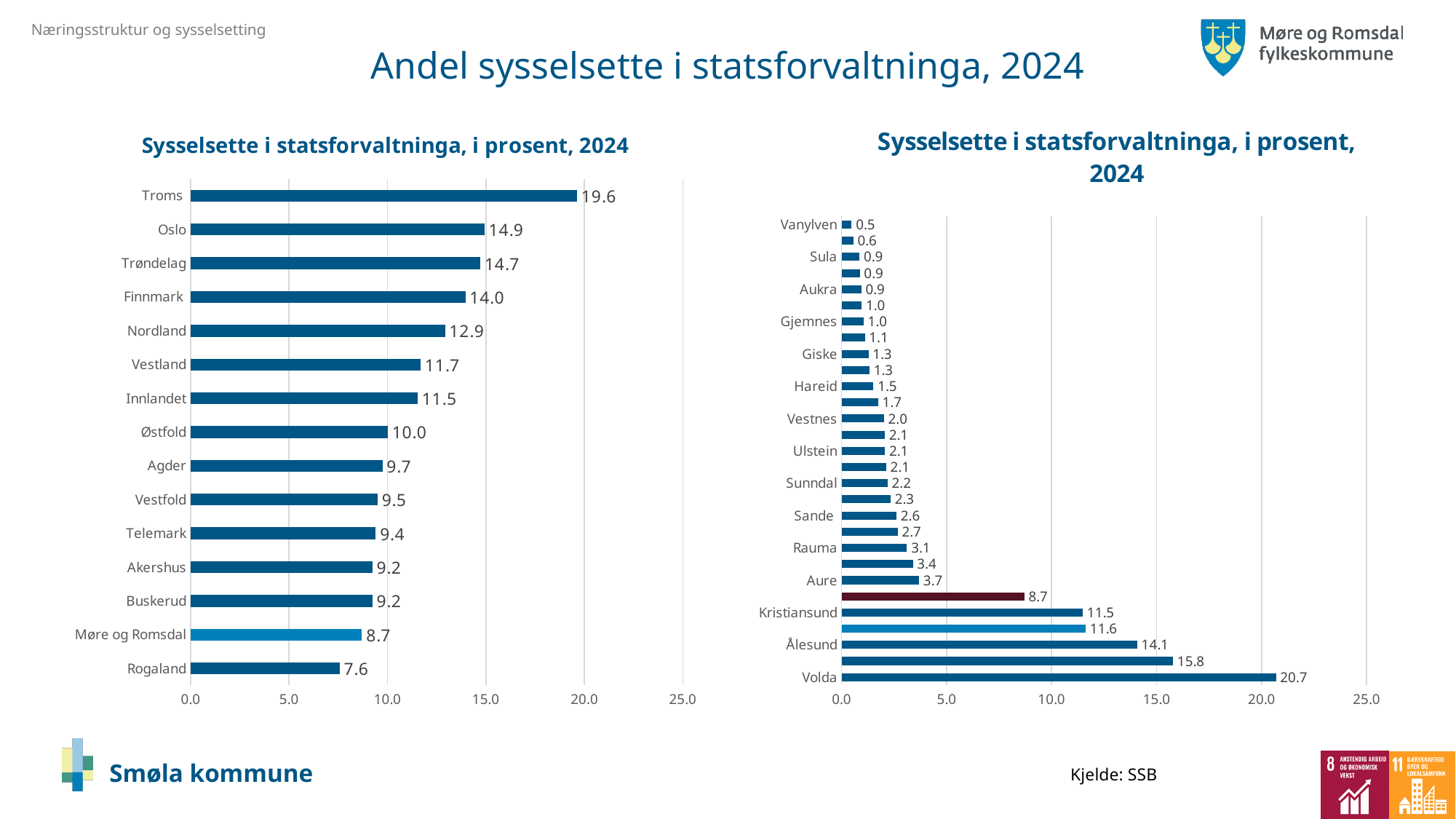
On the left chart, what is the value for Troms? 19.6 On the left chart, what is the value for Møre og Romsdal? 8.7 On the left chart, which category has the lowest value? Rogaland On the left chart, which is larger, the value for Nordland or the value for Vestland? Nordland On the left chart, which category has the highest value? Troms On the right chart, what is the value for Volda? 20.7 On the left chart, how many categories are shown? 15 On the right chart, what is the difference between the values for Volda and Ålesund? 6.6 On the right chart, which labelled category has the highest value? Volda What kind of chart is the left chart? Bar chart On the left chart, which category's bar is shown in a lighter blue colour than the others? Møre og Romsdal On the left chart, what is the difference between the values for Oslo and Trøndelag? 0.2